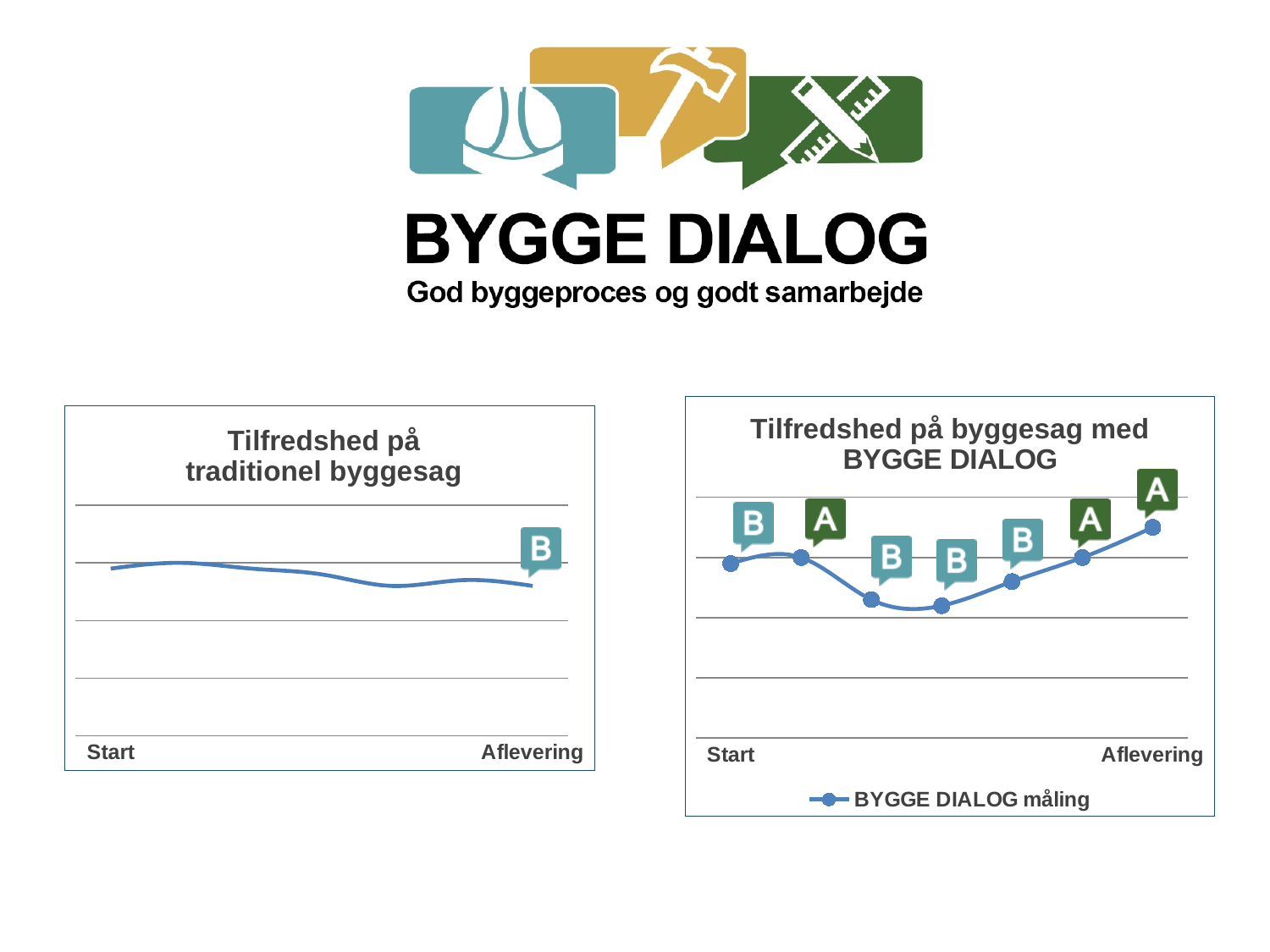
What kind of chart is the 'Tilfredshed på traditionel byggesag' chart? Line chart What is the legend entry in the 'Tilfredshed på byggesag med BYGGE DIALOG' chart? BYGGE DIALOG måling In the 'Tilfredshed på byggesag med BYGGE DIALOG' chart, does the line rise or fall between the second and third points? Fall What kind of chart is the 'Tilfredshed på byggesag med BYGGE DIALOG' chart? Line chart In the 'Tilfredshed på byggesag med BYGGE DIALOG' chart, how many data points are marked on the line? 7 In the 'Tilfredshed på byggesag med BYGGE DIALOG' chart, does the line end higher or lower than it starts? Higher What is the title of the chart on the left of the slide? Tilfredshed på traditionel byggesag In the 'Tilfredshed på byggesag med BYGGE DIALOG' chart, is the value at Aflevering higher or lower than the value at Start? Higher In the 'Tilfredshed på byggesag med BYGGE DIALOG' chart, which point on the line is the highest? The last point, at Aflevering How many series does the legend of the 'Tilfredshed på byggesag med BYGGE DIALOG' chart list? 1 What are the two x-axis labels shown on the 'Tilfredshed på traditionel byggesag' chart? Start and Aflevering